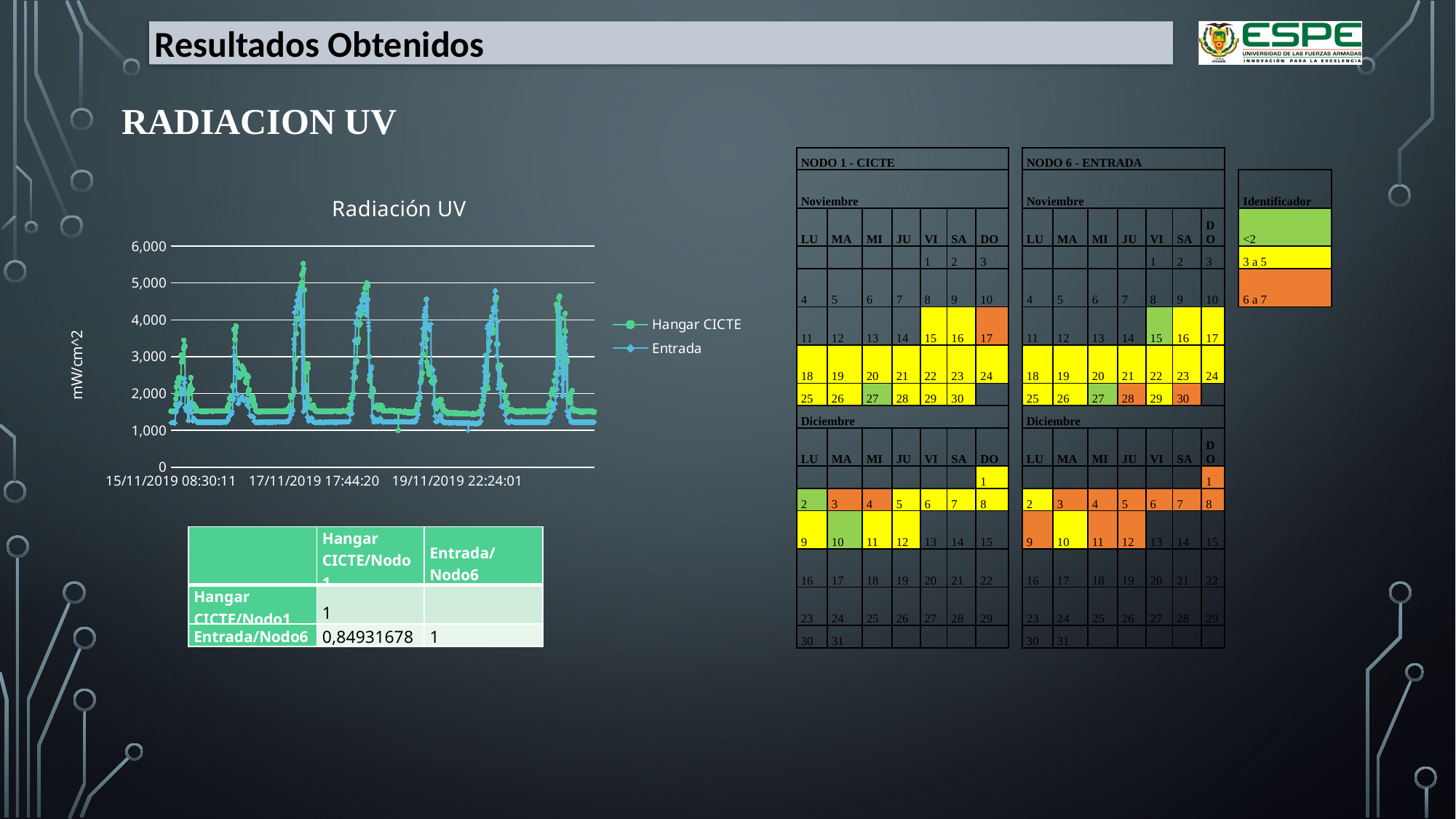
What kind of chart is the 'Radiación UV' chart? line chart What is the highest tick value shown on the y-axis of the 'Radiación UV' chart? 6,000 In the 'Radiación UV' chart, which series has the higher baseline (flat night-time) values, Hangar CICTE or Entrada? Hangar CICTE What is the y-axis label of the 'Radiación UV' chart? mW/cm^2 How many date labels are printed on the x-axis of the 'Radiación UV' chart? 3 What are the two series named in the legend of the 'Radiación UV' chart? Hangar CICTE and Entrada In the 'Radiación UV' chart, is the highest peak of the Hangar CICTE series greater or less than 5,000? greater What is the last date label shown on the x-axis of the 'Radiación UV' chart? 19/11/2019 22:24:01 How many series does the legend of the 'Radiación UV' chart list? 2 What is the first date label shown on the x-axis of the 'Radiación UV' chart? 15/11/2019 08:30:11 In the 'Radiación UV' chart, does any value of either series exceed 6,000? No In the 'Radiación UV' chart, is the lowest (baseline) value of the Entrada series greater or less than 2,000? less